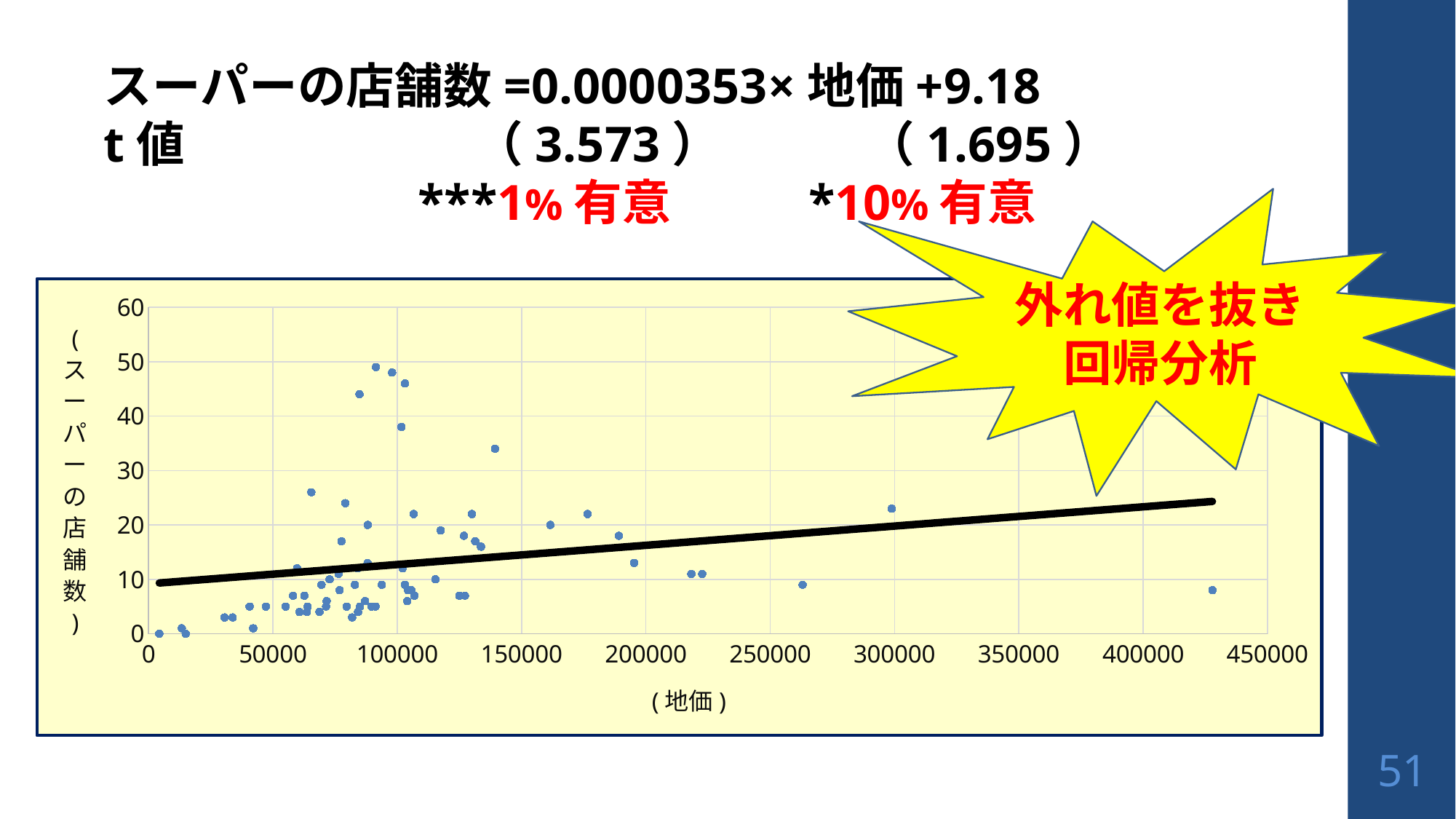
Is the regression line's value at 地価 400000 greater or less than 20? greater Is the highest plotted point on the chart greater or less than 40 on the y axis? greater Does the black regression line rise or fall as 地価 increases along the x axis? rise Is the value of the plotted point near 地価 300000 greater or less than 20? greater Which plotted point is higher: the one near 地価 300000 or the one near 地価 430000? the one near 300000 What kind of chart is shown on the slide? scatter chart What is the label of the x axis of the chart? (地価) What is the label of the y axis of the chart? (スーパーの店舗数)